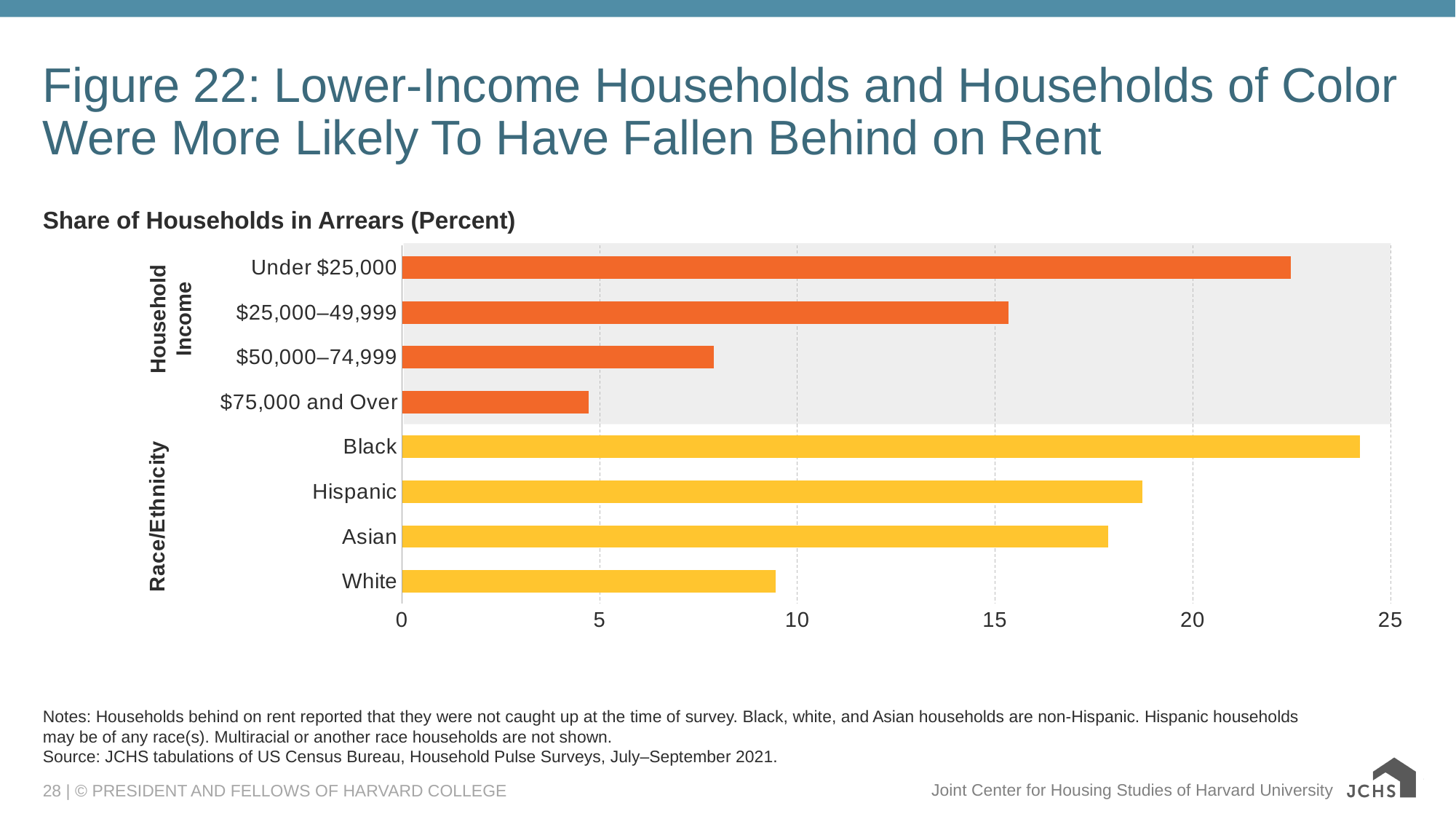
Is the value for $50,000–74,999 greater or less than 10? less Is the value for Under $25,000 greater or less than 20? greater How many categories are plotted in the chart? 8 Which is larger, the value for White or the value for $50,000–74,999? White Among the race/ethnicity groups, which has the lowest share of households in arrears? White Which category has the lowest share of households in arrears? $75,000 and Over Do the values rise or fall as household income increases from Under $25,000 to $75,000 and Over? fall What kind of chart is shown on the slide? bar chart Which is larger, the value for Black or the value for Under $25,000? Black Which category has the highest share of households in arrears? Black Is the value for Hispanic greater or less than 20? less Among the household income groups, which has the highest share of households in arrears? Under $25,000